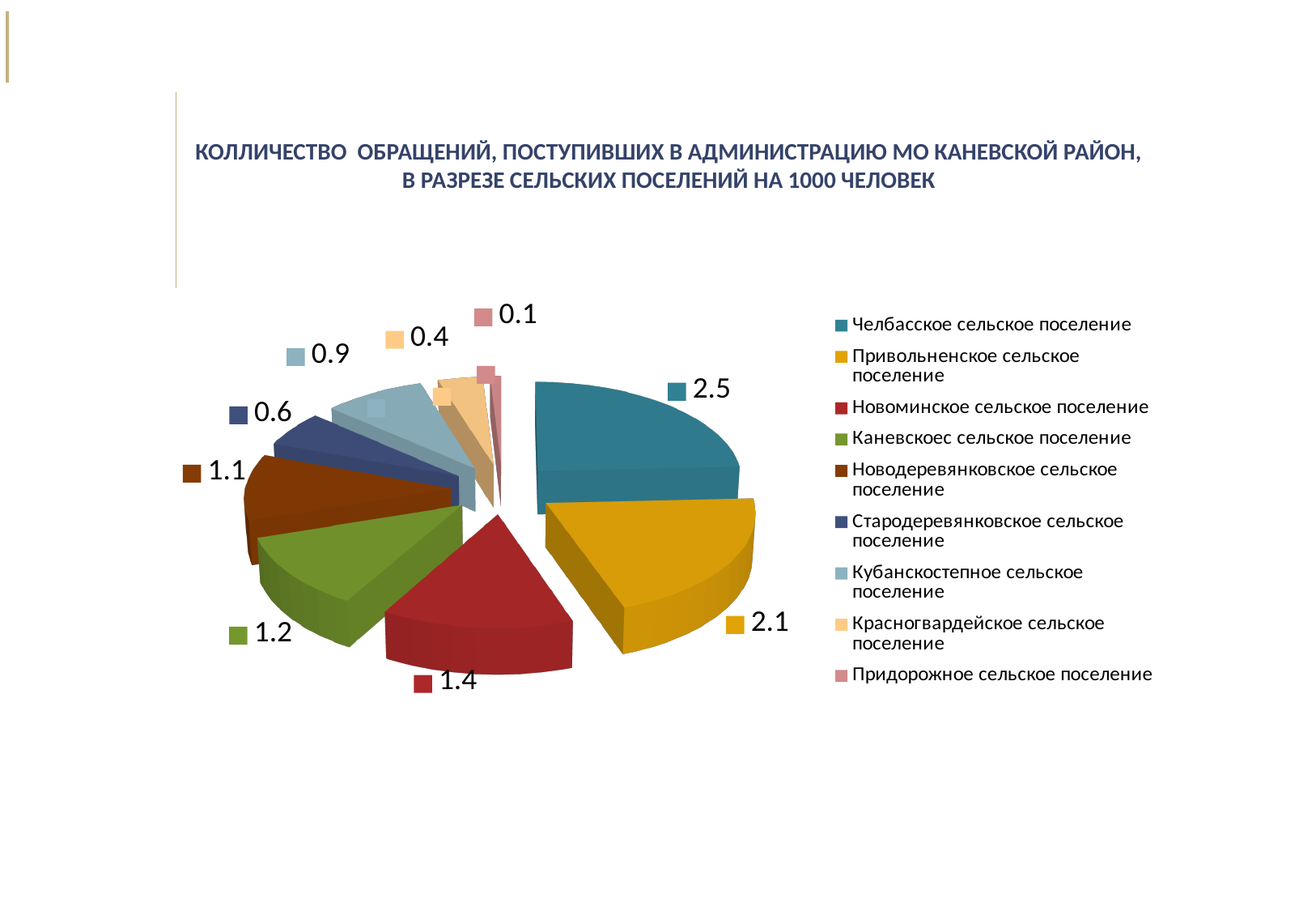
What is the value for Челбасское сельское поселение? 2.5 What kind of chart is shown on the slide? pie chart What is the value for Привольненское сельское поселение? 2.1 What is the difference between the values for Стародеревянковское сельское поселение and Красногвардейское сельское поселение? 0.2 What is the difference between the values for Челбасское сельское поселение and Привольненское сельское поселение? 0.4 Which settlement has the lowest value? Придорожное сельское поселение What is the value for Кубанскостепное сельское поселение? 0.9 Which settlement has the highest value? Челбасское сельское поселение How many entries does the legend list? 9 Which is larger, the value for Каневское сельское поселение or Новодеревянковское сельское поселение? Каневское сельское поселение What is the value for Новоминское сельское поселение? 1.4 How many slices does the pie chart have? 9